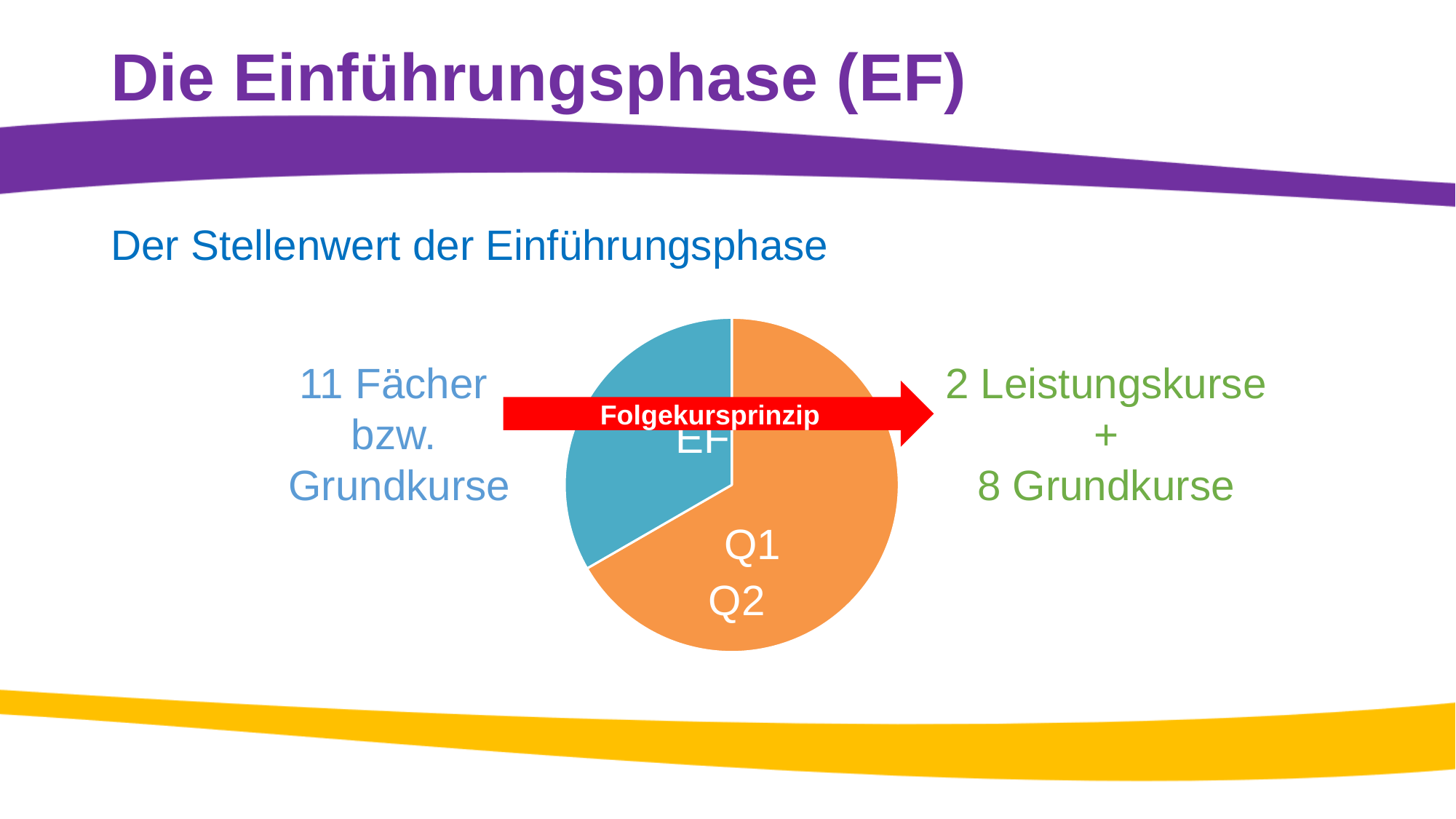
Which slice of the pie chart is larger, EF or Q1 Q2? Q1 Q2 What colour is the EF slice of the pie chart? blue Which slice of the pie chart is the largest? Q1 Q2 What kind of chart is shown on the slide? pie chart Which slice of the pie chart is the smallest? EF What colour is the Q1 Q2 slice of the pie chart? orange How many slices does the pie chart have? 2